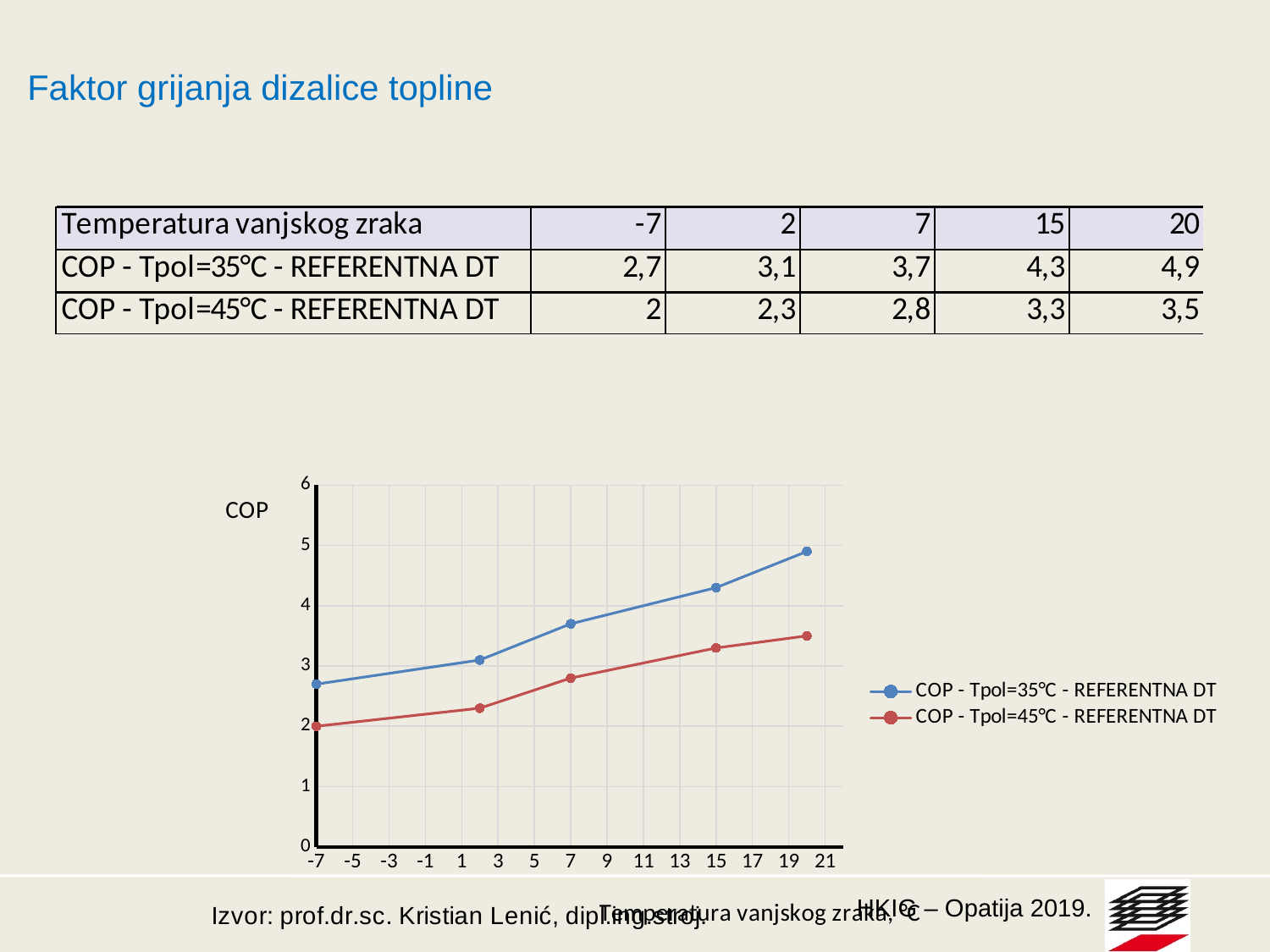
At which outdoor air temperature is the COP for Tpol=35°C highest? 20 What is the COP for Tpol=35°C at an outdoor air temperature of 7? 3,7 Which series has the higher COP at an outdoor air temperature of 2: Tpol=35°C or Tpol=45°C? COP - Tpol=35°C - REFERENTNA DT What is the difference between the COP for Tpol=35°C and Tpol=45°C at an outdoor air temperature of 15? 1 What is the COP for Tpol=35°C at an outdoor air temperature of -7? 2,7 What colour is the line for COP - Tpol=45°C - REFERENTNA DT in the chart? red What type of chart is shown on the slide? line chart How many data points does each series in the chart have? 5 What is the COP for Tpol=45°C at an outdoor air temperature of 20? 3,5 Do the COP values rise or fall as the outdoor air temperature increases along the x axis? rise How many series does the chart legend list? 2 At which outdoor air temperature is the COP for Tpol=45°C lowest? -7